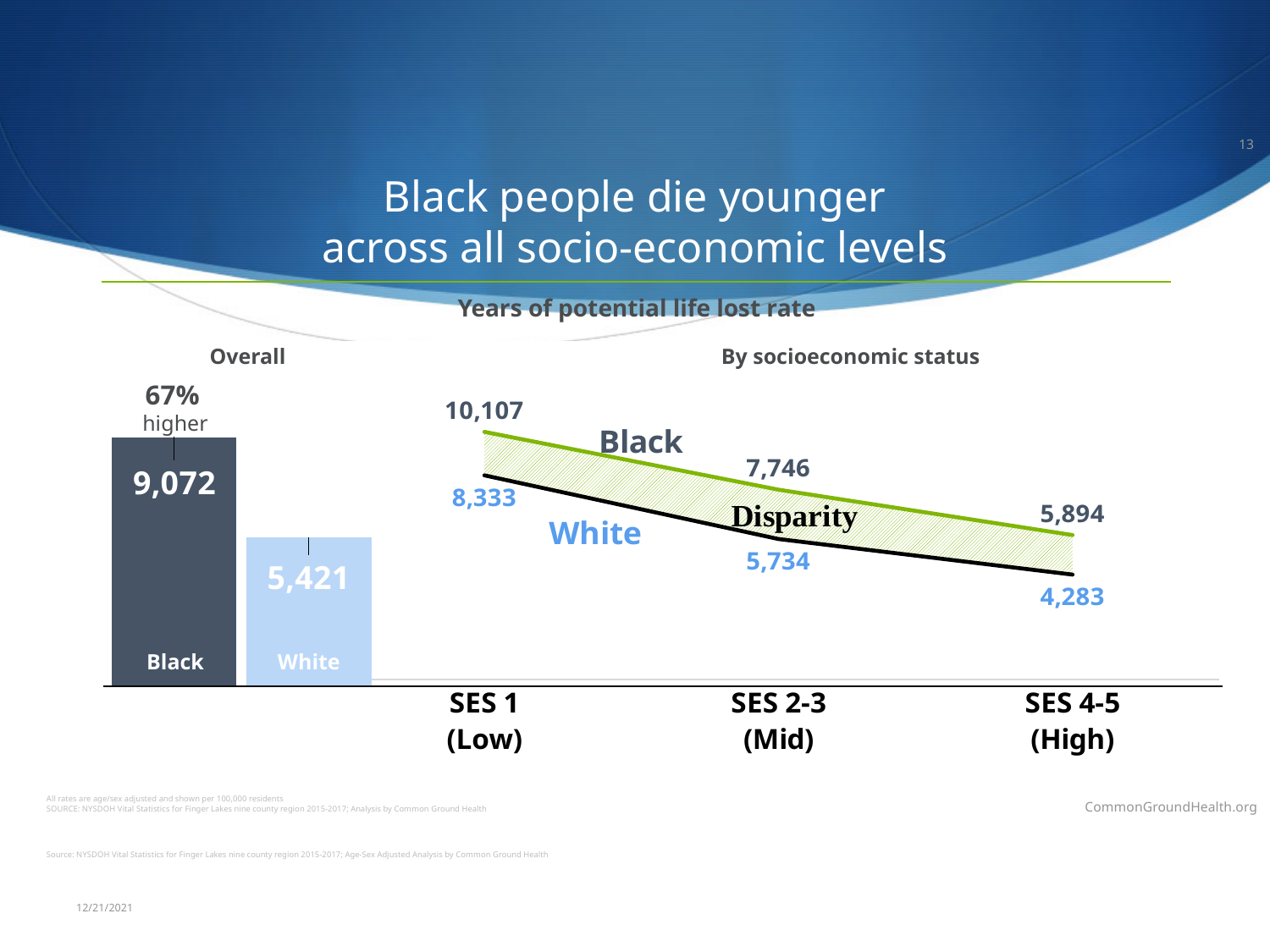
In the Overall chart, what is the years of potential life lost rate for White people? 5,421 In the Overall chart, which group has the higher rate, Black or White? Black In the Overall chart, what is the years of potential life lost rate for Black people? 9,072 In the By socioeconomic status chart, which group has the lowest rate at SES 1 (Low)? White In the By socioeconomic status chart, what is the Black rate for SES 1 (Low)? 10,107 In the By socioeconomic status chart, how many socioeconomic status categories are shown on the x axis? 3 What kind of chart is the Overall chart? Bar chart In the By socioeconomic status chart, what is the Black rate for SES 4-5 (High)? 5,894 In the By socioeconomic status chart, do the Black and White rates rise or fall as socioeconomic status increases from SES 1 to SES 4-5? Fall In the Overall chart, what is the difference between the Black and White rates? 3,651 In the By socioeconomic status chart, what is the difference between the Black and White rates at SES 4-5 (High)? 1,611 In the By socioeconomic status chart, what is the White rate for SES 2-3 (Mid)? 5,734